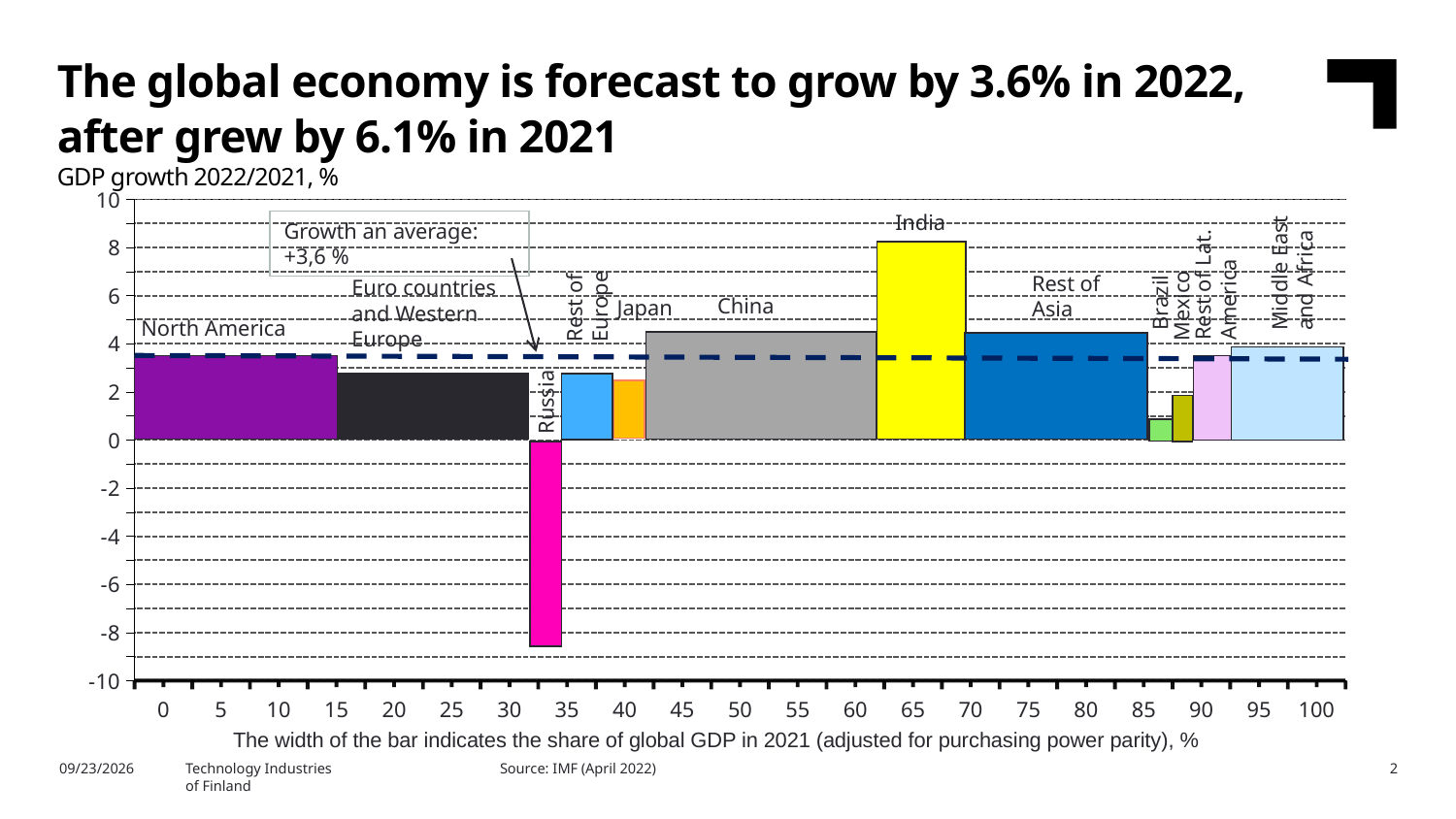
Which region has the highest GDP growth in the chart? India Which has higher GDP growth, Mexico or Brazil? Mexico Is the value for Russia greater or less than -6? less What average growth is stated in the annotation on the chart? +3,6 % Is the value for North America greater or less than 2? greater What type of chart is shown on the slide? Bar chart Is the value for India greater or less than 6? greater According to the note below the chart, what does the width of each bar indicate? The share of global GDP in 2021 (adjusted for purchasing power parity), % Which has higher GDP growth, India or China? India Which region has the lowest GDP growth in the chart? Russia